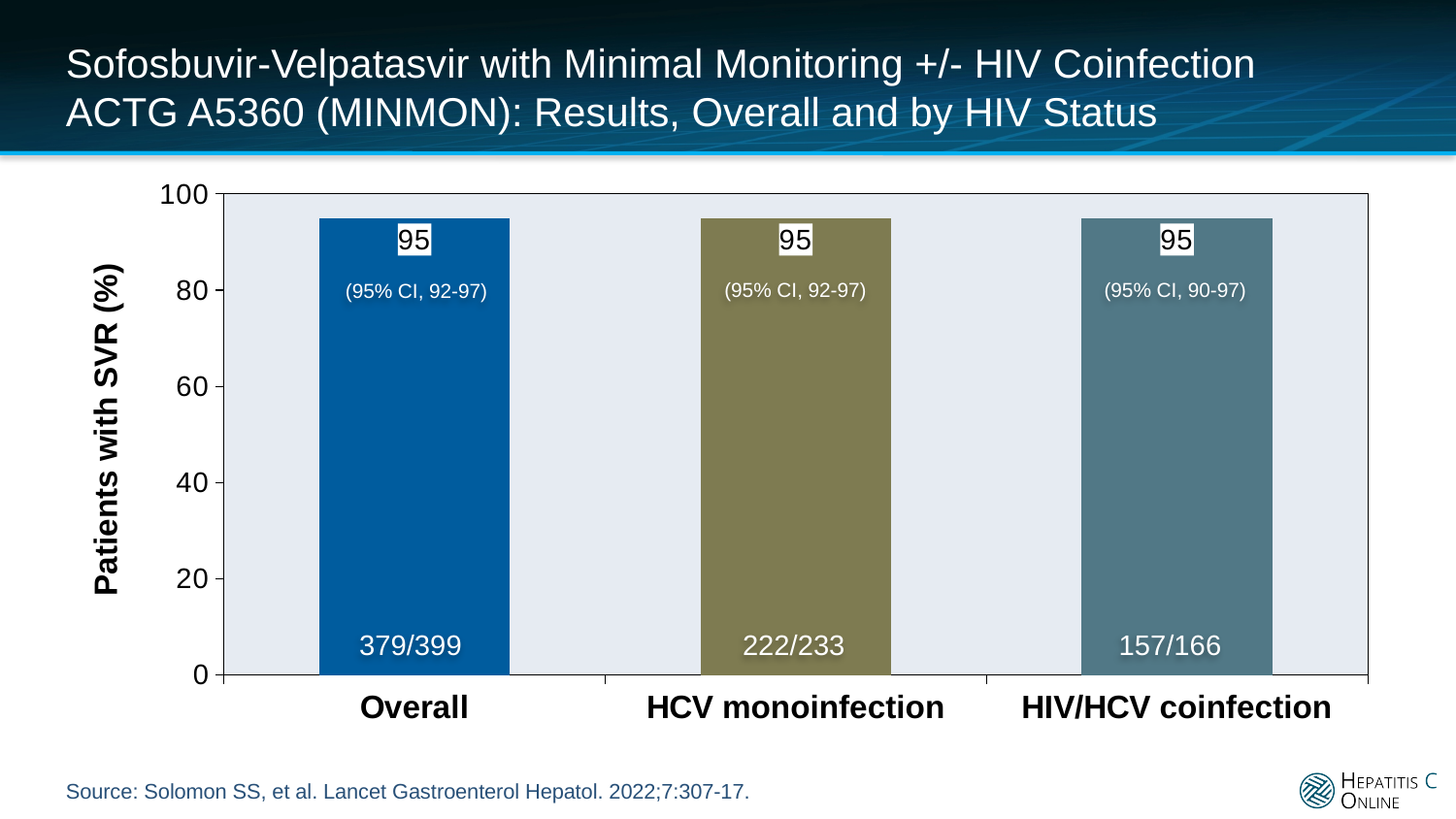
What kind of chart is shown on the slide? Bar chart What is the label on the y axis of the chart? Patients with SVR (%) What is the SVR value (%) for the HIV/HCV coinfection group? 95 What fraction of patients achieved SVR in the Overall group, as printed on the bar? 379/399 What is the 95% confidence interval printed for the HIV/HCV coinfection group? 95% CI, 90-97 What is the SVR value (%) for the HCV monoinfection group? 95 What is the SVR value (%) for the Overall group? 95 How many categories are shown on the x axis of the chart? 3 What is the 95% confidence interval printed for the Overall group? 95% CI, 92-97 What fraction of patients achieved SVR in the HIV/HCV coinfection group, as printed on the bar? 157/166 What fraction of patients achieved SVR in the HCV monoinfection group, as printed on the bar? 222/233 What is the difference between the SVR values for the Overall group and the HIV/HCV coinfection group? 0